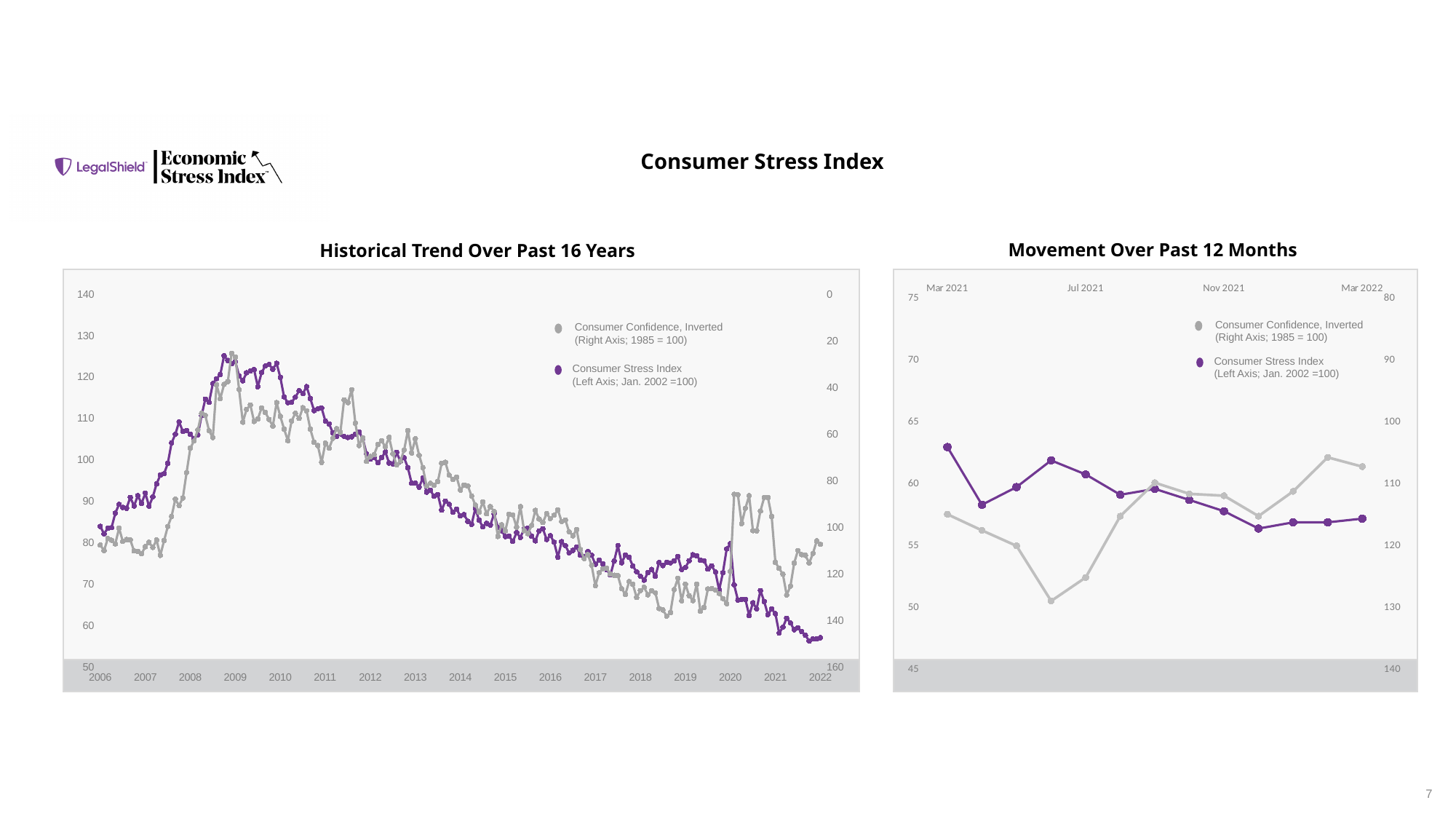
In the 'Movement Over Past 12 Months' chart, is the Consumer Stress Index value for Mar 2021 greater or less than 60? greater In the 'Historical Trend Over Past 16 Years' chart, which series is plotted in purple? Consumer Stress Index In the 'Movement Over Past 12 Months' chart, is the Consumer Stress Index value for Mar 2022 greater or less than 60? less What kind of chart is the 'Movement Over Past 12 Months' chart? line chart In the 'Historical Trend Over Past 16 Years' chart, does the Consumer Stress Index rise or fall overall from 2010 to 2022? fall What is the title of the chart on the right side of the slide? Movement Over Past 12 Months How many series does the legend of the 'Movement Over Past 12 Months' chart list? 2 How many series does the legend of the 'Historical Trend Over Past 16 Years' chart list? 2 In the 'Movement Over Past 12 Months' chart, how many data points does the Consumer Stress Index line have? 13 What kind of chart is the 'Historical Trend Over Past 16 Years' chart? line chart In the 'Movement Over Past 12 Months' chart, does the Consumer Stress Index rise or fall overall from Mar 2021 to Mar 2022? fall In the 'Historical Trend Over Past 16 Years' chart, is the Consumer Stress Index value at the start of 2022 greater or less than 60? less